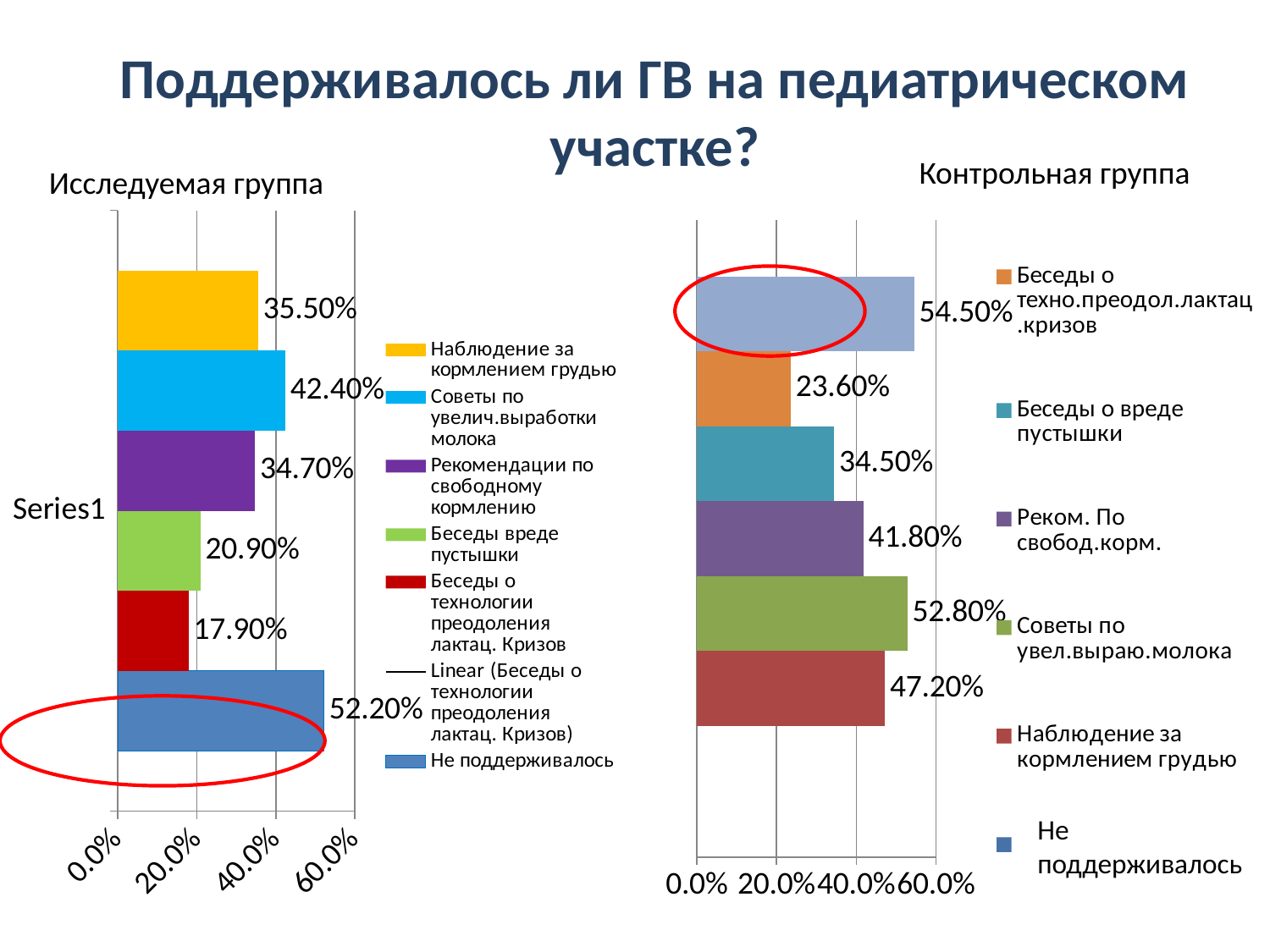
In the 'Исследуемая группа' chart, what is the value for 'Советы по увелич.выработки молока'? 42.40% In the 'Контрольная группа' chart, what is the value for the orange bar ('Беседы о техно.преодол.лактац.кризов')? 23.60% In the 'Исследуемая группа' chart, is the value for 'Рекомендации по свободному кормлению' greater or less than 40.0%? less In the 'Контрольная группа' chart, which category has the highest value? Не поддерживалось In the 'Исследуемая группа' chart, what is the value for 'Не поддерживалось'? 52.20% In the 'Контрольная группа' chart, which is larger: 'Советы по увел.выраю.молока' or 'Реком. По свобод.корм.'? Советы по увел.выраю.молока In the 'Контрольная группа' chart, what is the difference between 'Не поддерживалось' and 'Беседы о вреде пустышки'? 20.00% In the 'Исследуемая группа' chart, which category has the lowest value? Беседы о технологии преодоления лактац. Кризов How many bars are plotted in the 'Контрольная группа' chart? 6 What type of chart is the 'Исследуемая группа' chart? Bar chart In the 'Контрольная группа' chart, what is the value for 'Наблюдение за кормлением грудью'? 47.20% In the 'Исследуемая группа' chart, what is the difference between 'Наблюдение за кормлением грудью' and 'Беседы вреде пустышки'? 14.60%